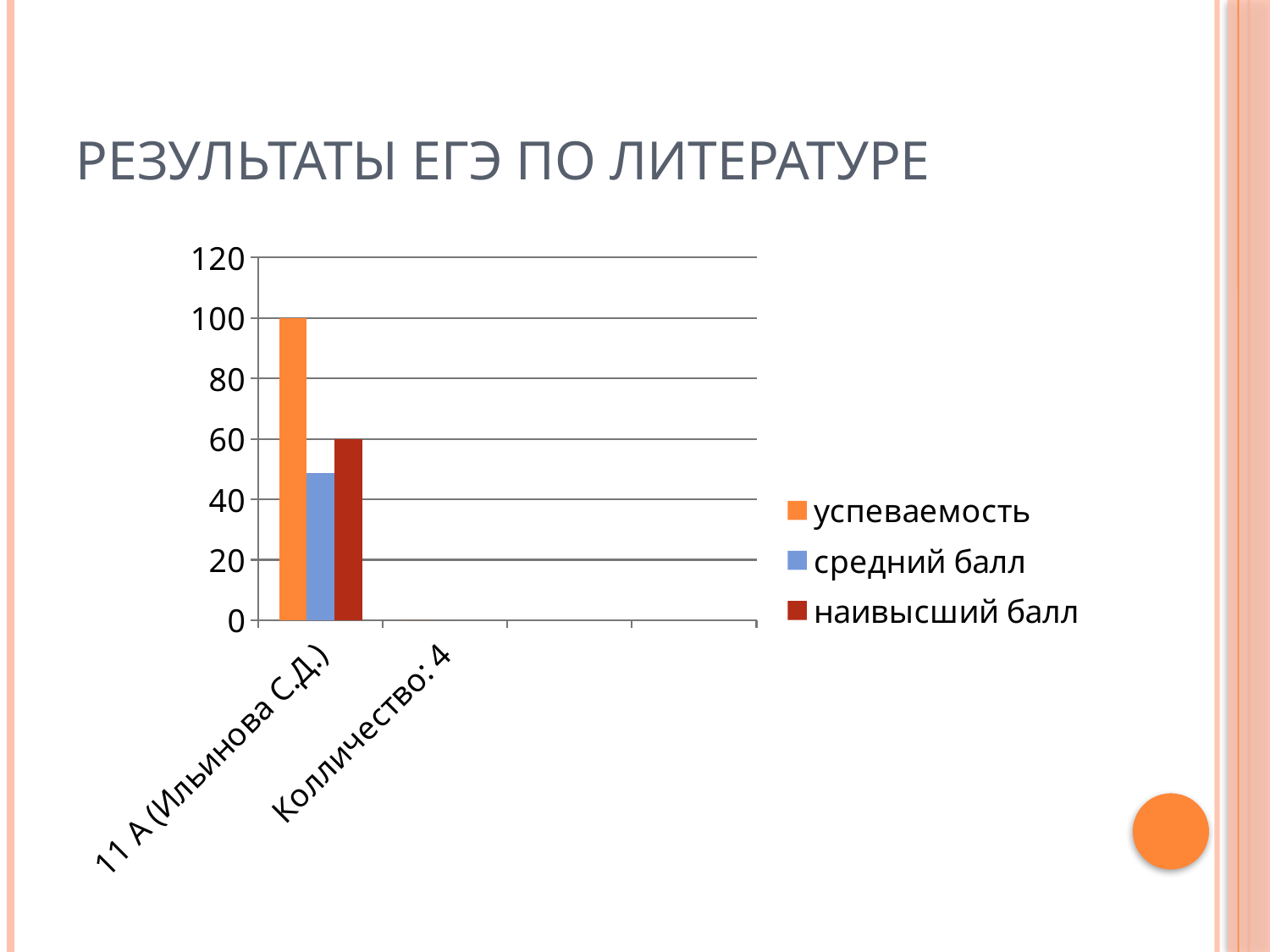
What is the value of наивысший балл for 11 А (Ильинова С.Д.)? 60 What is the value of успеваемость for 11 А (Ильинова С.Д.)? 100 Is the value of средний балл for 11 А (Ильинова С.Д.) greater or less than 60? less What is the difference between успеваемость and наивысший балл for 11 А (Ильинова С.Д.)? 40 Which series has the highest value for 11 А (Ильинова С.Д.)? успеваемость For 11 А (Ильинова С.Д.), which is larger: средний балл or наивысший балл? наивысший балл What is the title of the slide? РЕЗУЛЬТАТЫ ЕГЭ ПО ЛИТЕРАТУРЕ How many series does the legend list? 3 Is the value of средний балл for 11 А (Ильинова С.Д.) greater or less than 40? greater What colour represents успеваемость in the legend? orange What kind of chart is shown on the slide? bar chart Which series has the lowest value for 11 А (Ильинова С.Д.)? средний балл